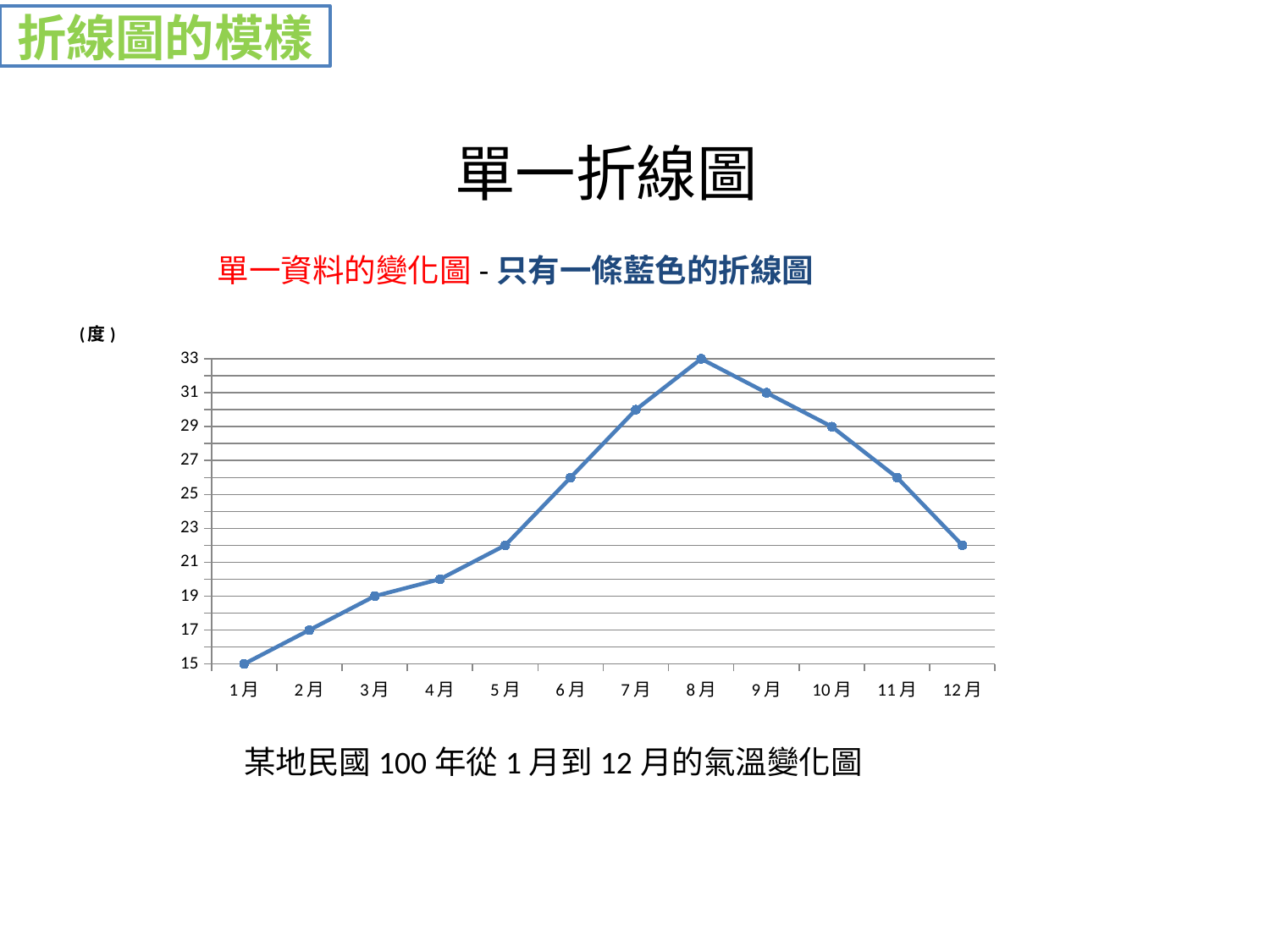
What is the temperature value for 3月? 19 Which month has the highest temperature? 8月 Is the value for 12月 greater or less than 25? less How many months are plotted on the x axis? 12 What is the temperature value for 8月? 33 What is the temperature value for 1月? 15 What type of chart is shown on the slide? line chart Does the temperature rise or fall from 1月 to 8月? rise What is the difference between the temperature in 8月 and the temperature in 1月? 18 Which month has the lowest temperature? 1月 Which month has a higher temperature, 7月 or 3月? 7月 What is the temperature value for 9月? 31